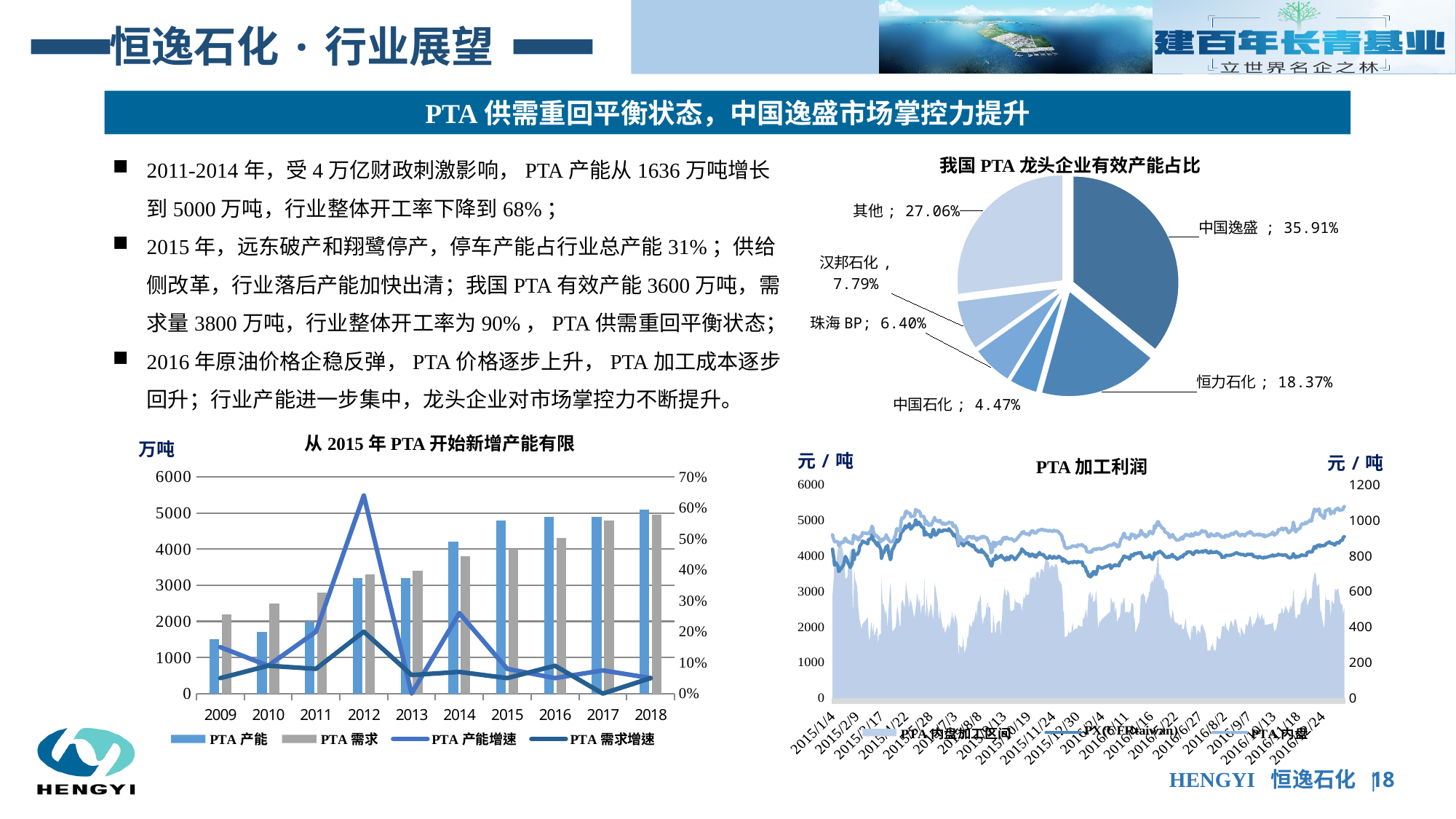
In the pie chart 我国PTA龙头企业有效产能占比, what share does 中国逸盛 hold? 35.91% In the chart 从2015年PTA开始新增产能有限, in which year does the PTA产能增速 line reach its peak? 2012 In the pie chart 我国PTA龙头企业有效产能占比, how many slices are there? 6 In the chart 从2015年PTA开始新增产能有限, is the PTA产能 bar for 2015 greater or less than 4000? greater What kind of chart is 我国PTA龙头企业有效产能占比? pie chart In the pie chart 我国PTA龙头企业有效产能占比, what share does 恒力石化 hold? 18.37% In the chart 从2015年PTA开始新增产能有限, how many years are shown on the x axis? 10 In the chart 从2015年PTA开始新增产能有限, is the PTA产能 bar for 2009 greater or less than 2000? less In the chart 从2015年PTA开始新增产能有限, how many series does the legend list? 4 In the pie chart 我国PTA龙头企业有效产能占比, which is larger, the share of 汉邦石化 or 珠海BP? 汉邦石化 In the pie chart 我国PTA龙头企业有效产能占比, which named company has the smallest share? 中国石化 In the pie chart 我国PTA龙头企业有效产能占比, what is the difference between the shares of 中国逸盛 and 恒力石化? 17.54%